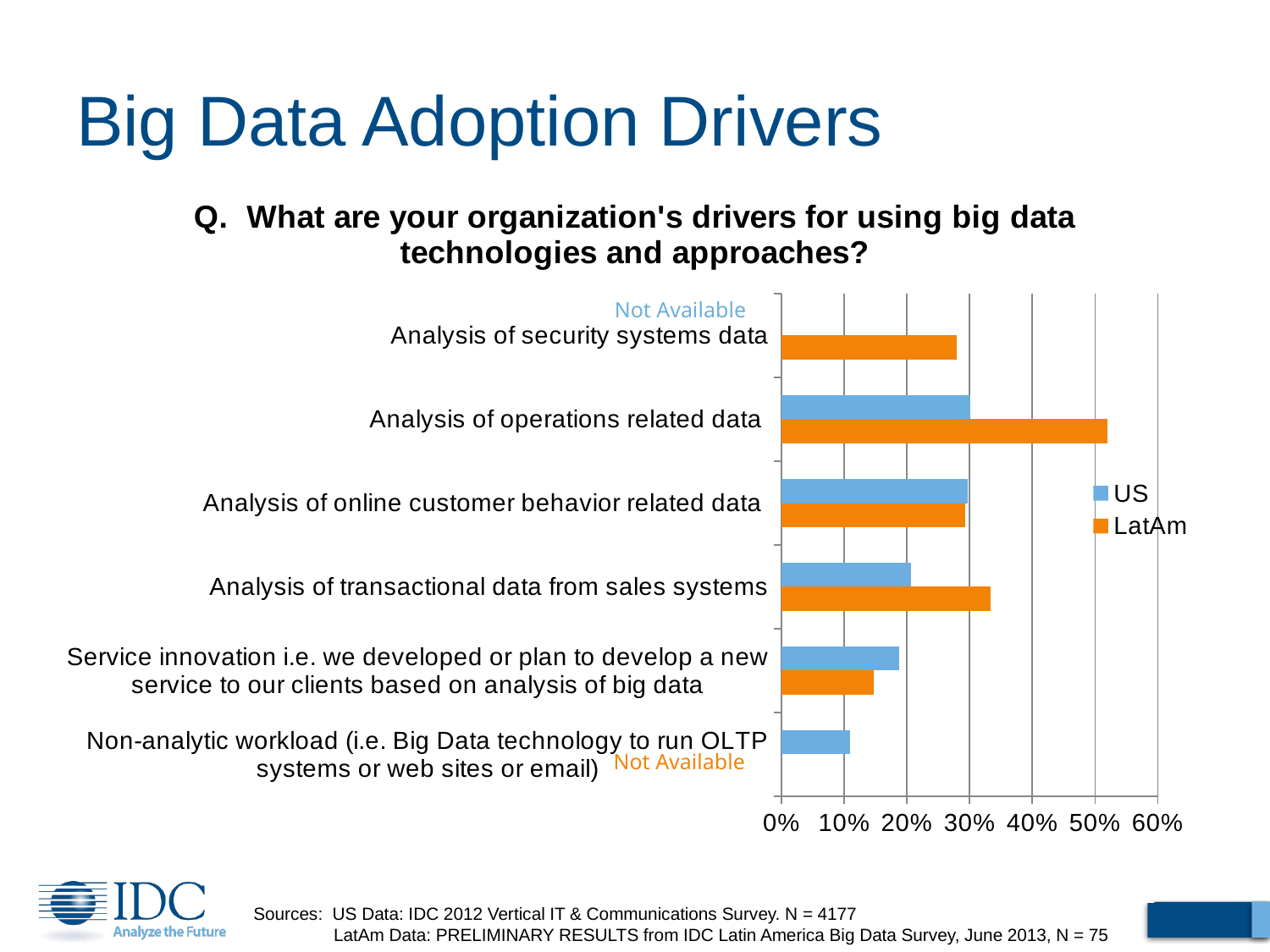
How many categories are shown on the chart? 6 Which category has the lowest US value? Non-analytic workload (i.e. Big Data technology to run OLTP systems or web sites or email) Is the LatAm value for Analysis of operations related data greater or less than 50%? greater Is the US value for Non-analytic workload greater or less than 20%? less For Service innovation, which is larger, the US value or the LatAm value? US Is the LatAm value for Analysis of transactional data from sales systems greater or less than 30%? greater Which series is marked as Not Available for Analysis of security systems data? US For Analysis of operations related data, which is larger, the US value or the LatAm value? LatAm What kind of chart is shown on the slide? bar chart How many series does the legend list? 2 Which category has the highest LatAm value? Analysis of operations related data Which series is shown in orange? LatAm